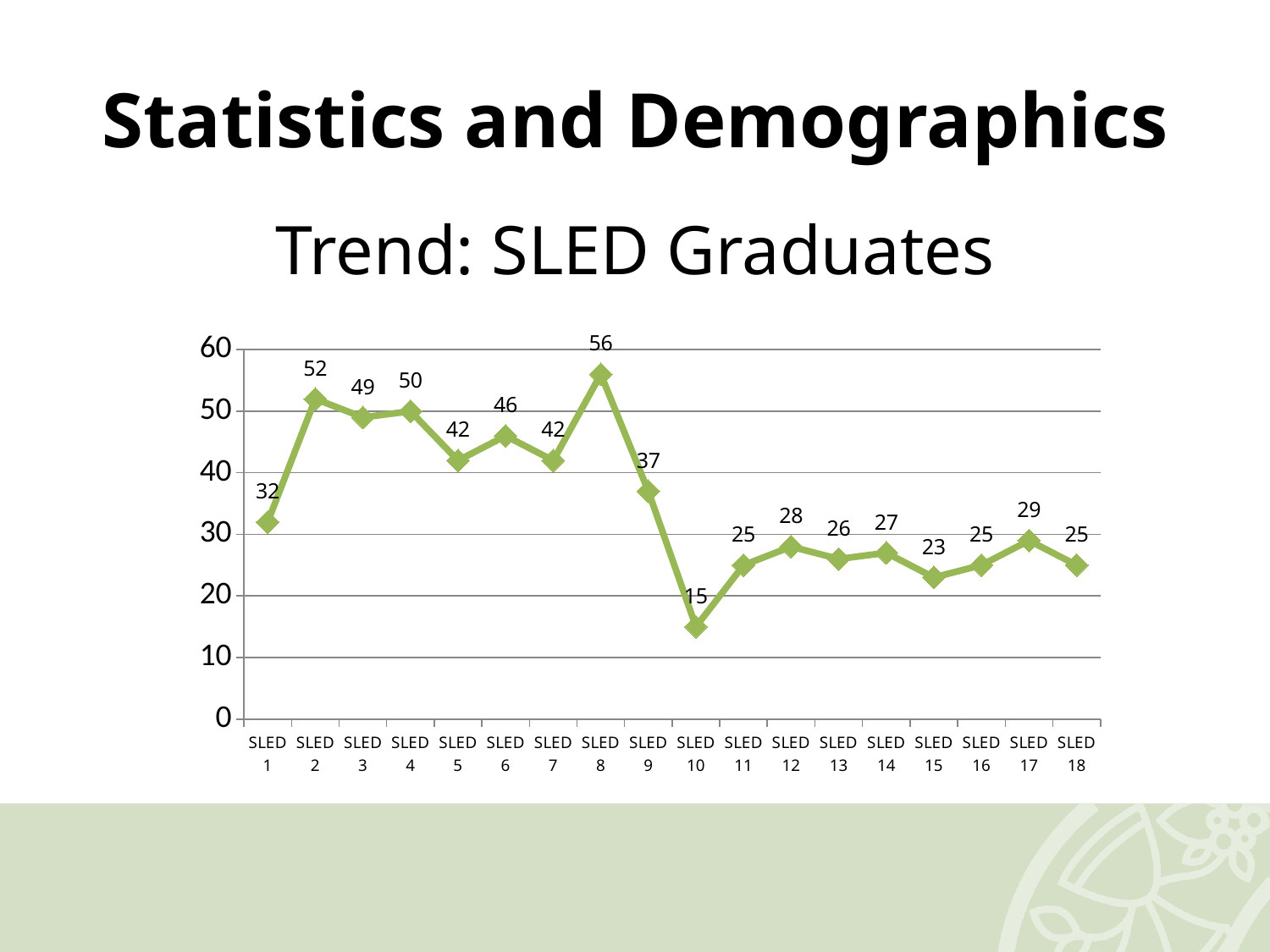
What is the value for SLED 10? 15 What is the value for SLED 1? 32 What is the title of the chart? Trend: SLED Graduates Which is larger, the value for SLED 9 or the value for SLED 17? SLED 9 How many categories are plotted on the chart? 18 What kind of chart is shown on the slide? Line chart Which category has the highest value? SLED 8 What is the difference between the values for SLED 8 and SLED 10? 41 What is the difference between the values for SLED 2 and SLED 18? 27 What is the value for SLED 8? 56 Which category has the lowest value? SLED 10 Do the values generally rise or fall from SLED 8 to SLED 10? Fall